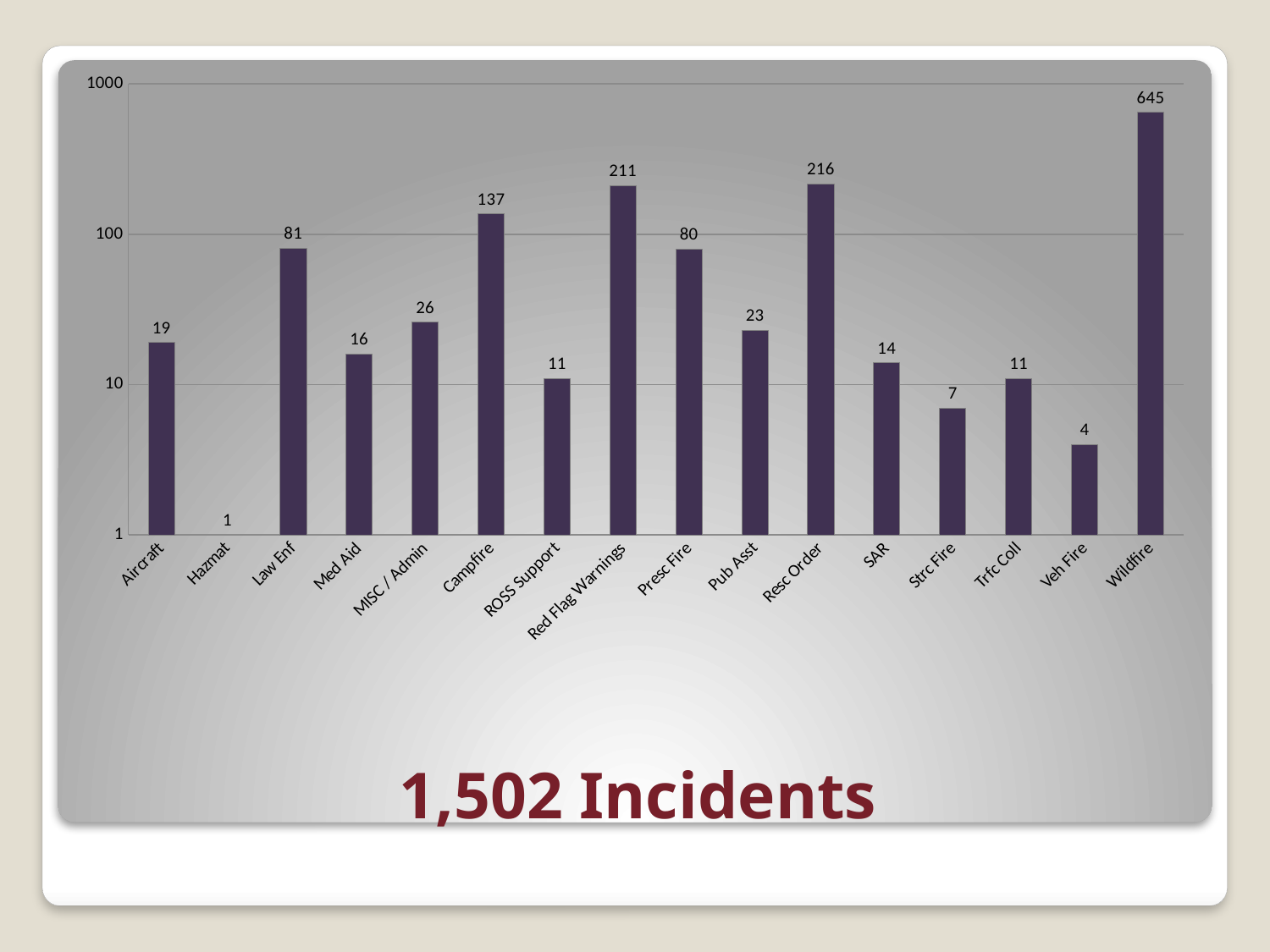
What is the value for Hazmat? 1 Which category has the highest value? Wildfire Is the value for Red Flag Warnings greater or less than 100? greater What is the value for Campfire? 137 What is the value for Wildfire? 645 What text appears below the chart on the slide? 1,502 Incidents What kind of chart is shown on the slide? Bar chart What is the value for Resc Order? 216 Which category has the lowest value? Hazmat Which is larger, the value for Law Enf or the value for Presc Fire? Law Enf How many categories are shown on the x axis? 16 What is the difference between the values for Wildfire and Resc Order? 429